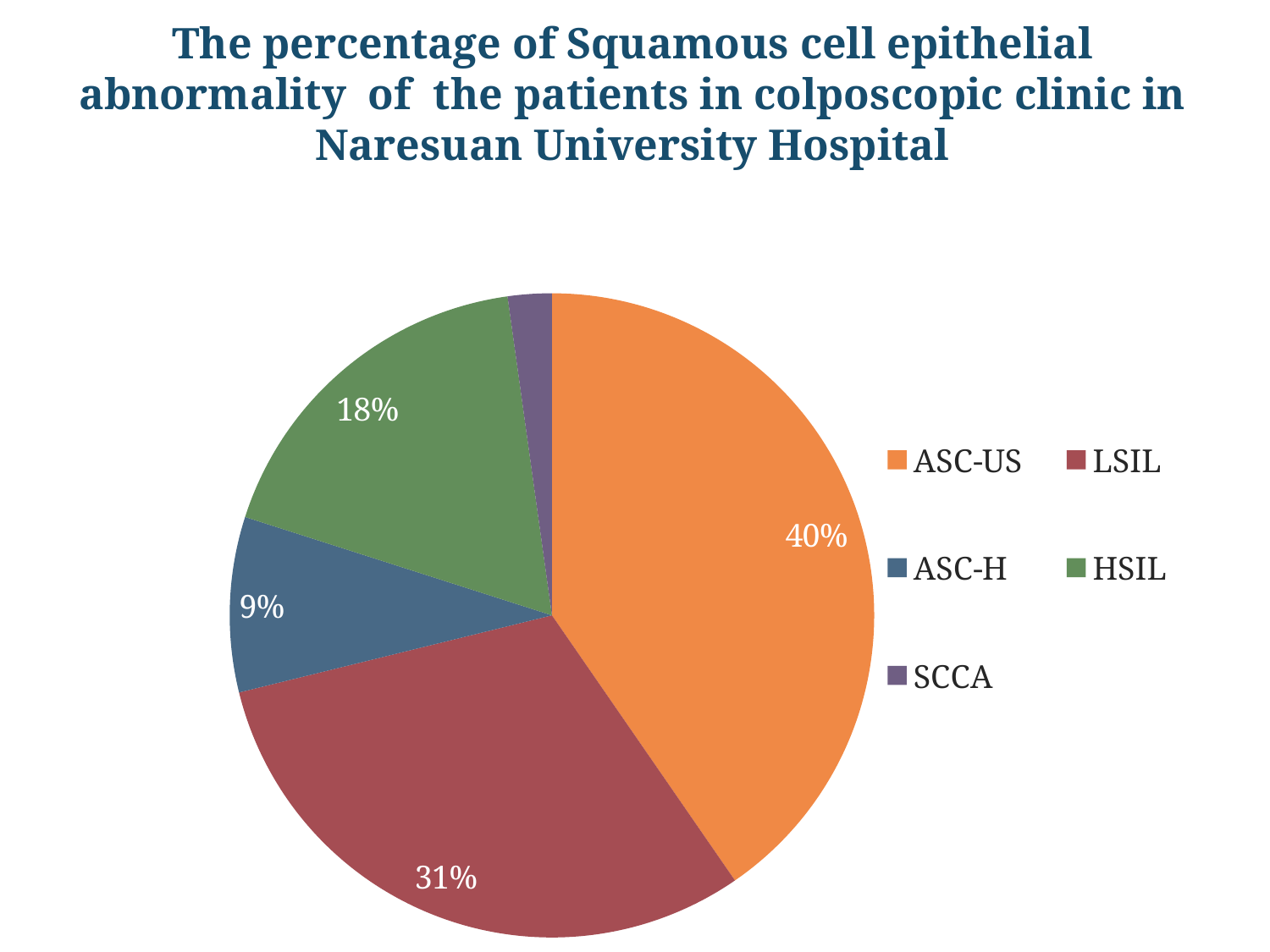
What is the difference in percentage points between HSIL and ASC-H? 9 What percentage of the pie is ASC-US? 40% What percentage of the pie is ASC-H? 9% Which category is shown in green in the legend? HSIL What percentage of the pie is LSIL? 31% What kind of chart is shown on the slide? Pie chart Which category has the largest share of the pie? ASC-US How many categories does the legend list? 5 What is the difference in percentage points between ASC-US and LSIL? 9 Which is larger, the share for LSIL or the share for HSIL? LSIL Which category has the smallest share of the pie? SCCA What percentage of the pie is HSIL? 18%